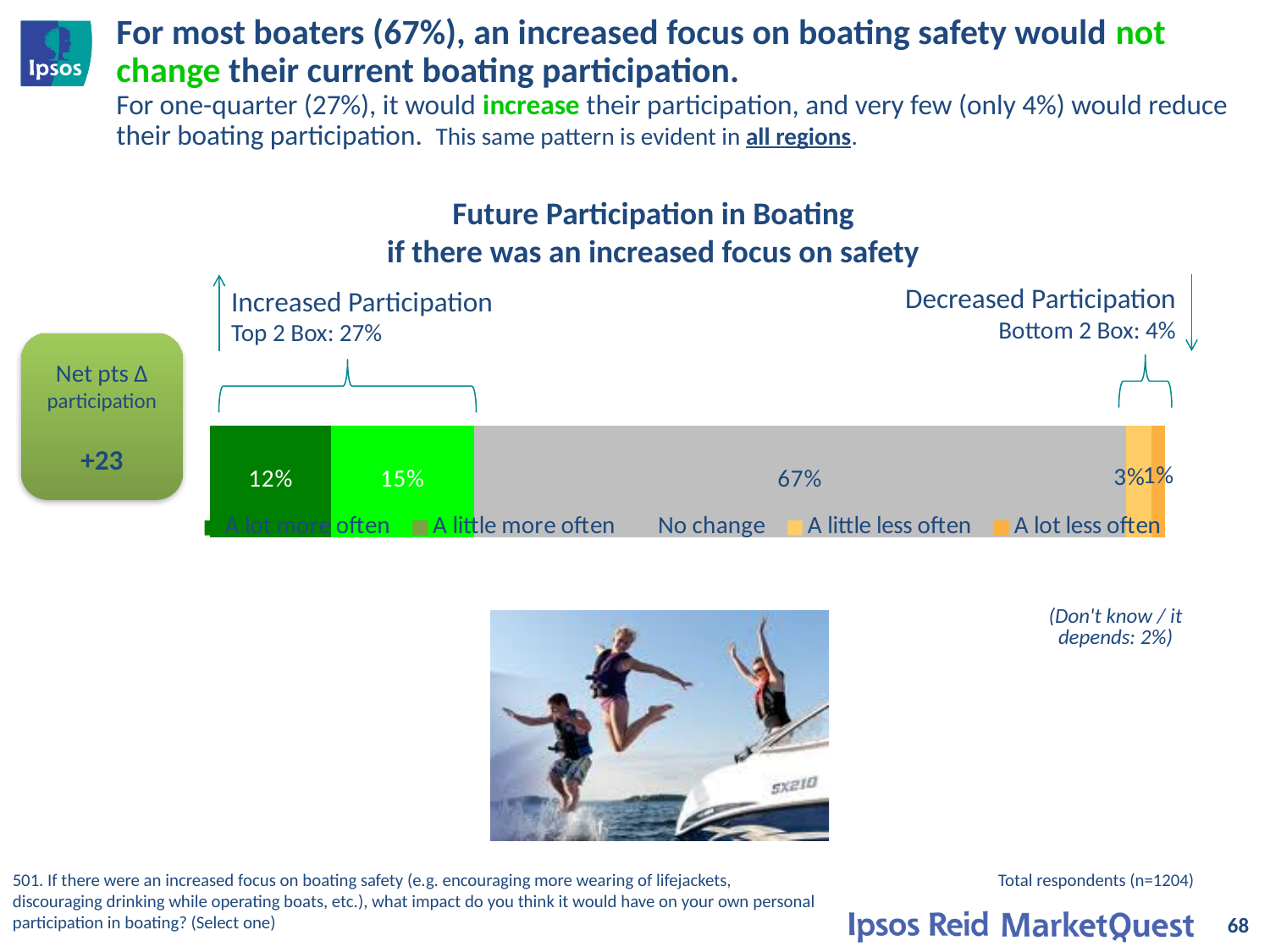
What is the value for 'A lot more often'? 12% Which response category has the lowest value? A lot less often What is the value for 'A little less often'? 3% What is the combined total of 'A lot more often' and 'A little more often'? 27% What is the difference between 'A little more often' and 'A lot more often'? 3 percentage points What percentage of boaters said there would be no change in their participation? 67% Which response category has the highest value? No change How many response categories does the legend list? 5 What is the value for 'A little more often'? 15% What kind of chart is shown on the slide? Stacked bar chart What is the value for 'A lot less often'? 1% Which is larger, 'A little more often' or 'A little less often'? A little more often